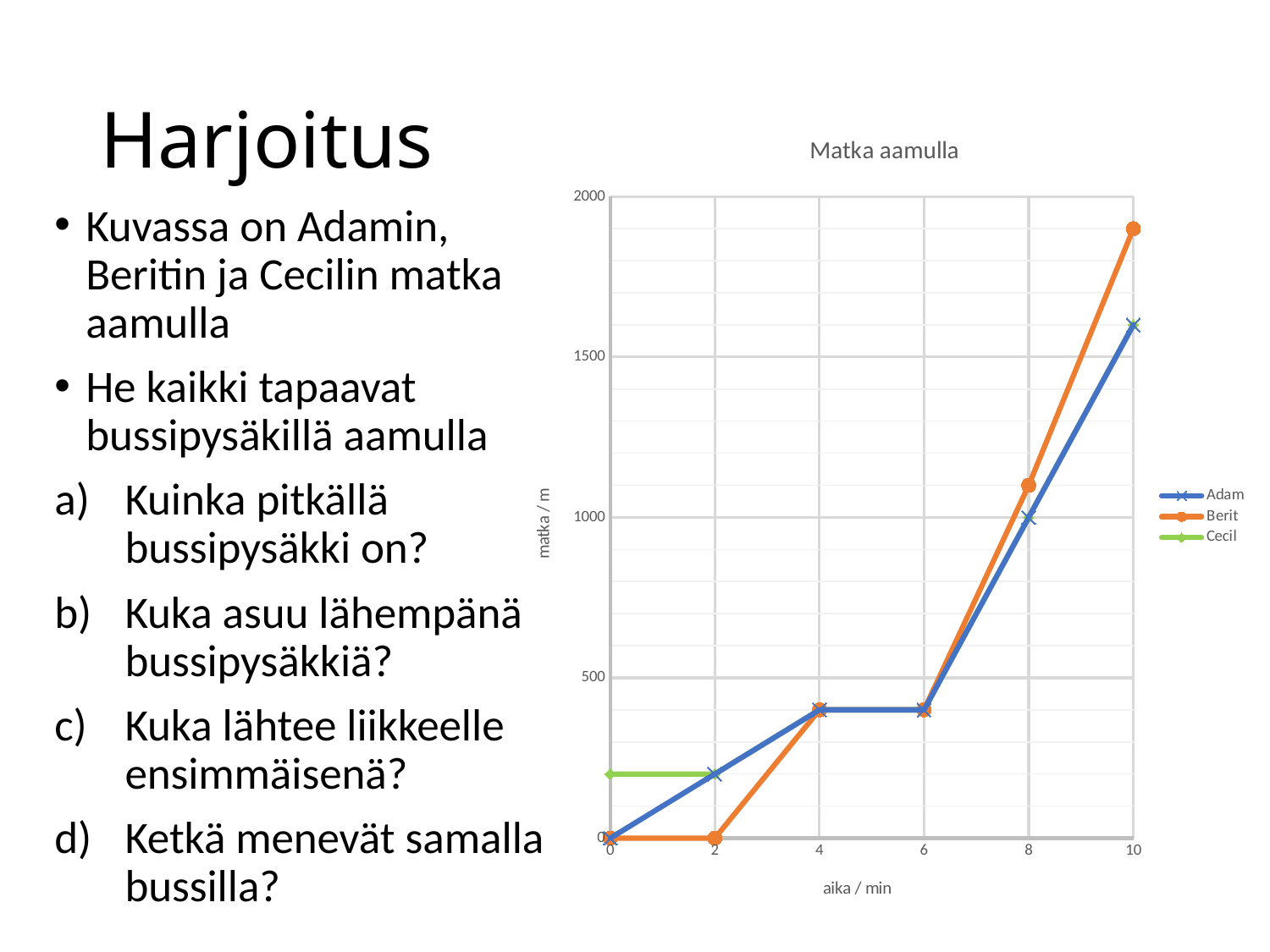
What is the value for Berit at 2 min? 0 Is the value for Adam at 4 min greater or less than 500? less What is the title of the chart? Matka aamulla At 2 min, which series has the higher value, Adam or Berit? Adam Does the value for Adam rise or fall from 0 min to 10 min? rise What is the value for Adam at 0 min? 0 What is the value for Adam at 8 min? 1000 At 10 min, which series has the higher value, Adam or Berit? Berit What type of chart is shown on the slide? line chart What is the label of the x axis of the chart? aika / min How many series does the chart legend list? 3 Is the value for Berit at 10 min greater or less than 1500? greater